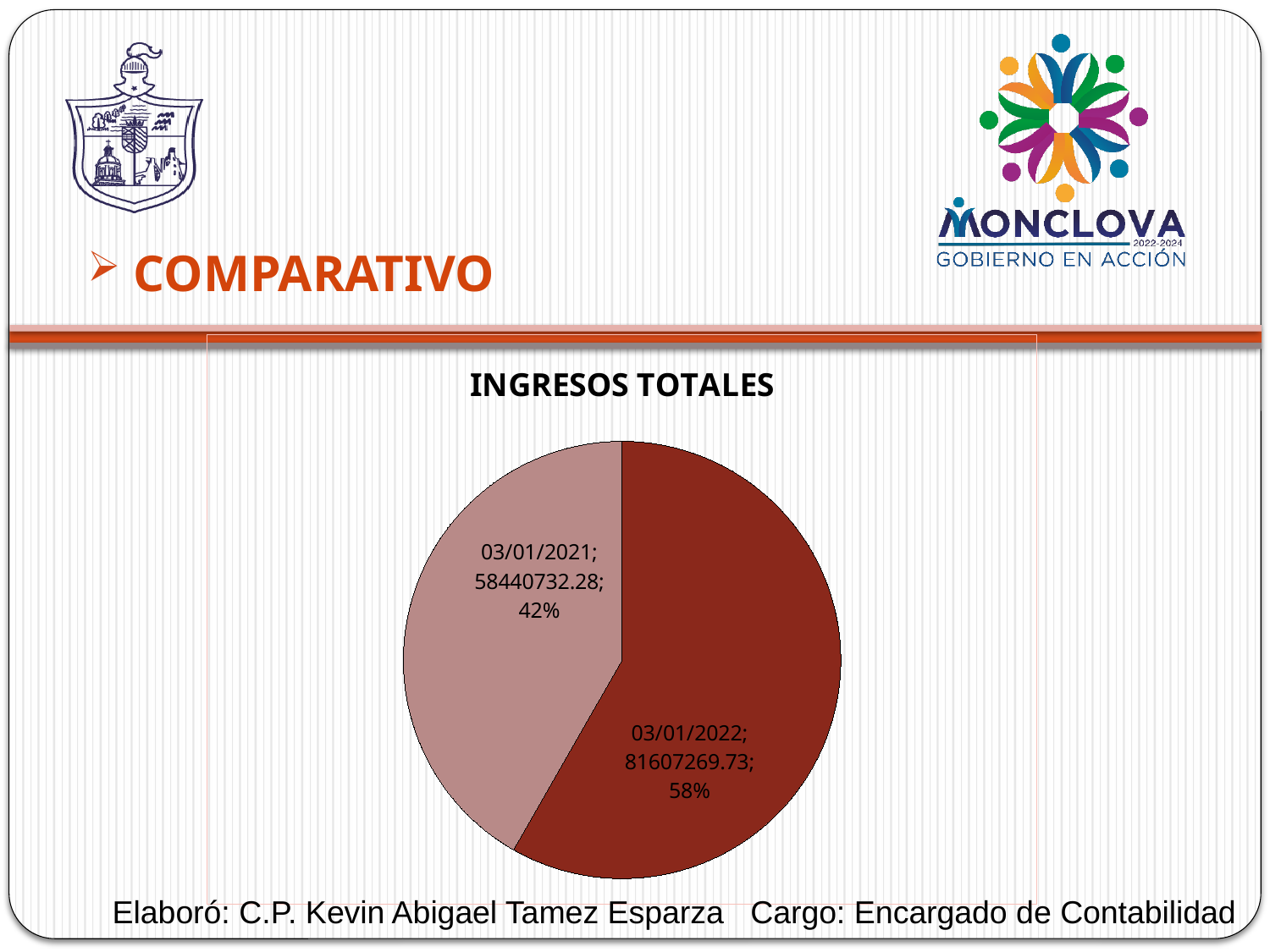
Which date has the larger slice of the pie? 03/01/2022 What is the total of the two values shown in the pie chart? 140048002.01 What share of the pie does the 03/01/2022 slice represent? 58% What is the value shown for 03/01/2022? 81607269.73 How many slices does the pie chart have? 2 Which date has the smaller slice of the pie? 03/01/2021 What share of the pie does the 03/01/2021 slice represent? 42% What is the title of the chart? INGRESOS TOTALES What is the difference between the values for 03/01/2022 and 03/01/2021? 23166537.45 Is the value for 03/01/2022 larger or smaller than the value for 03/01/2021? larger What is the value shown for 03/01/2021? 58440732.28 What kind of chart is shown under the title INGRESOS TOTALES? pie chart